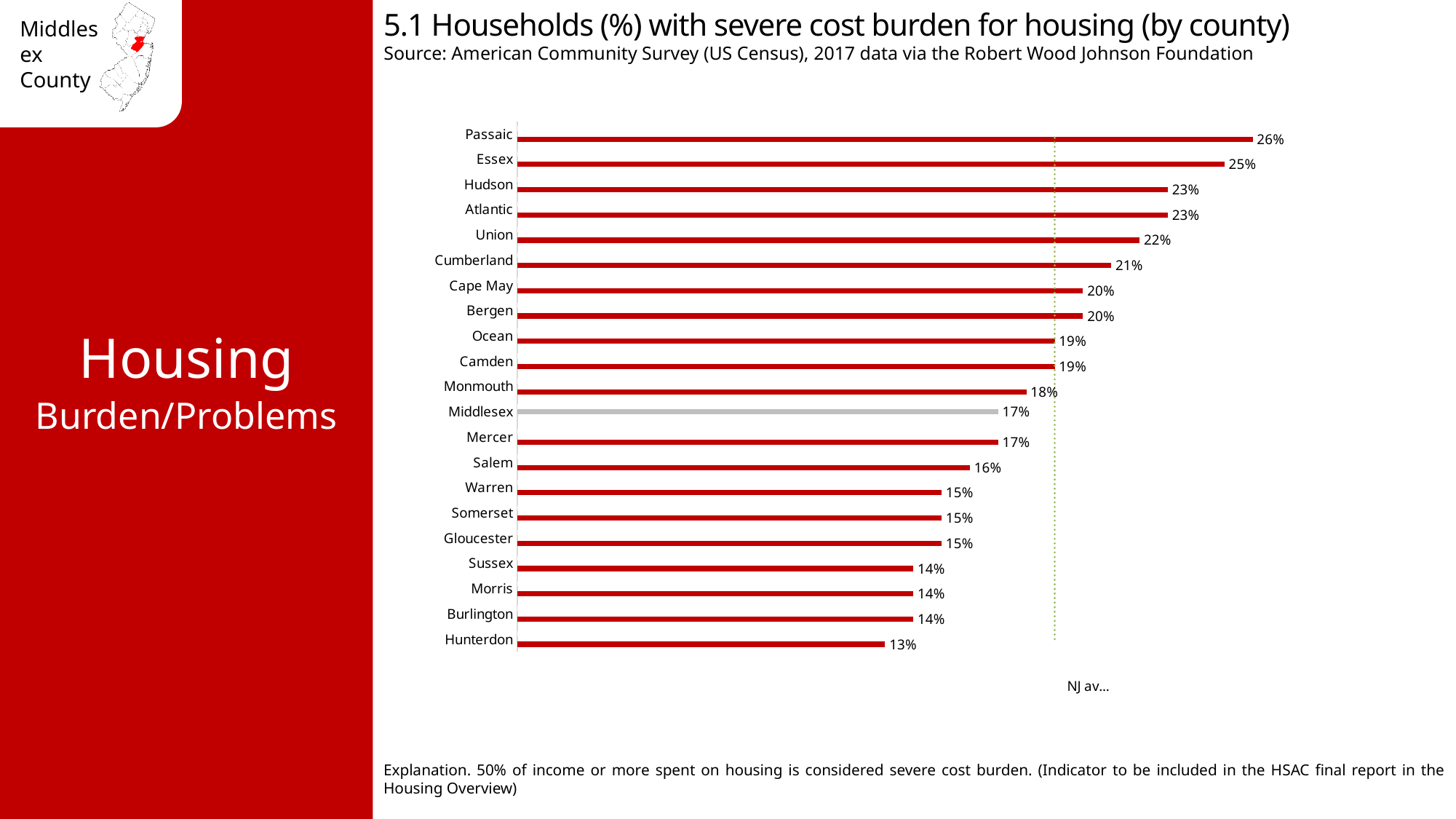
What kind of chart is shown on the slide? Bar chart Which county's bar is shown in grey rather than red? Middlesex Which county has the lowest percentage of households with severe cost burden? Hunterdon What is the value for Hunterdon? 13% What is the value for Middlesex? 17% What is the value for Cumberland? 21% How many counties are shown in the chart? 21 What is the difference between the values for Passaic and Hunterdon? 13% Which county has the highest percentage of households with severe cost burden? Passaic What is the difference between the values for Essex and Middlesex? 8% Which is larger, the value for Union or the value for Salem? Union What is the value for Passaic? 26%